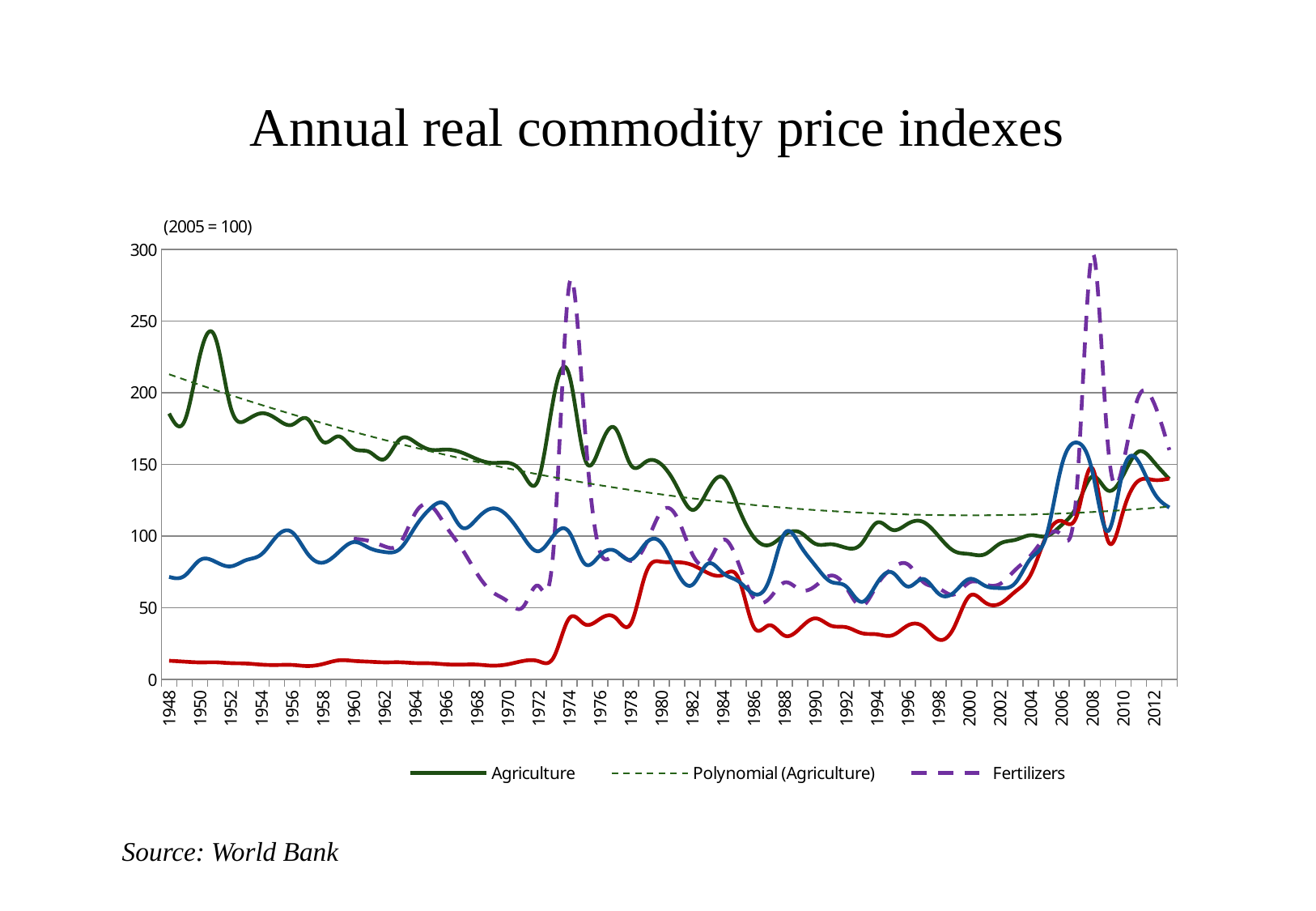
Is the Agriculture value in 2000 greater or less than 100? less What kind of chart is shown on the slide? line chart What is the title of the chart? Annual real commodity price indexes Is the Agriculture value in 1974 greater or less than 200? greater How many series does the legend list? 3 Does the Agriculture series generally rise or fall between 1948 and 2000? fall Is the Fertilizers value in 2008 greater or less than 250? greater In which year does the Fertilizers series reach its highest value? 2008 Which year is set as the base (= 100) for the indexes? 2005 In 1974, which series is higher, Agriculture or Fertilizers? Fertilizers